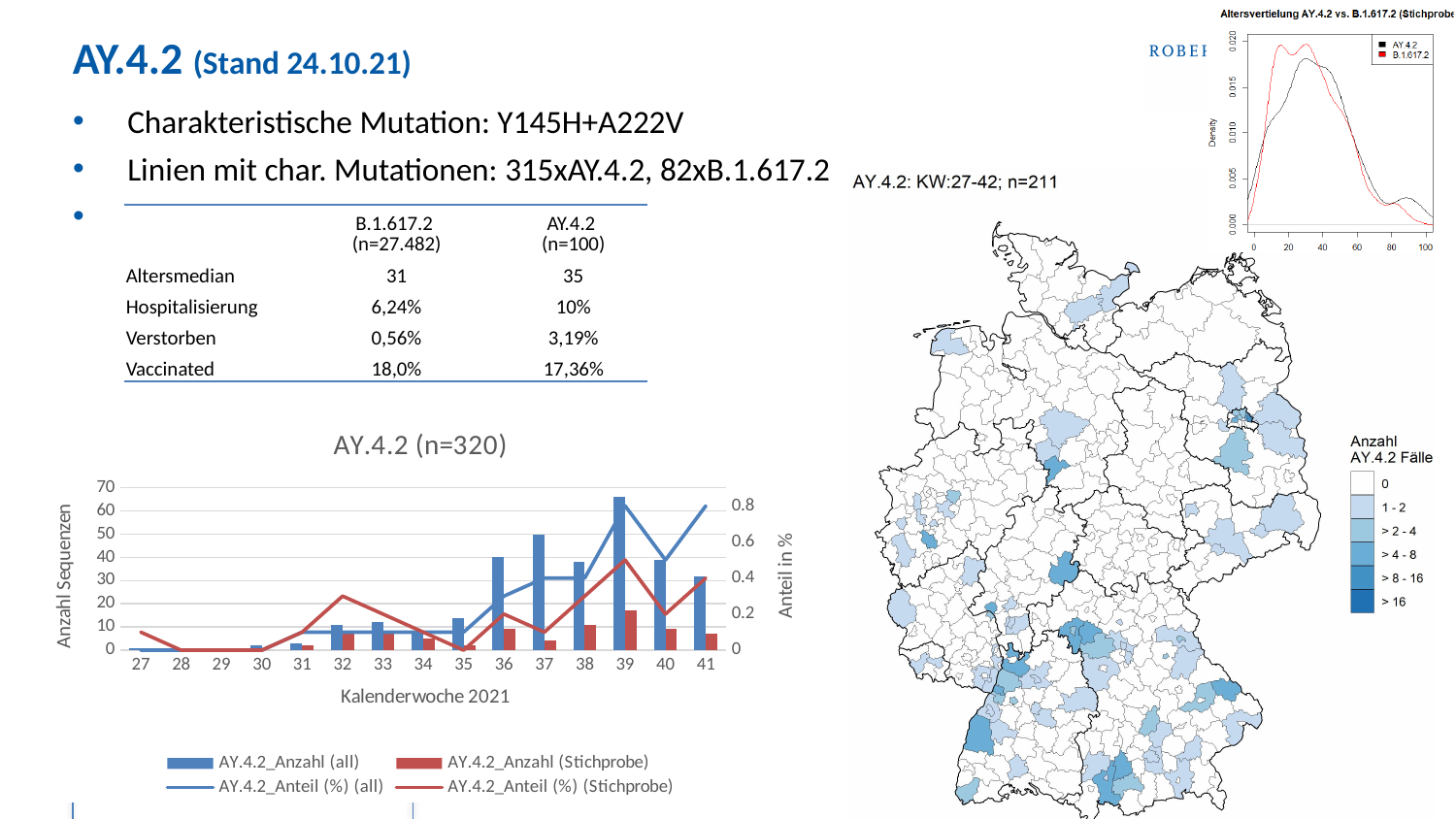
In the chart titled "AY.4.2 (n=320)", is the AY.4.2_Anzahl (all) value for week 36 greater or less than 30? greater In the chart titled "AY.4.2 (n=320)", which calendar week has the highest AY.4.2_Anzahl (all) bar? 39 In the chart titled "AY.4.2 (n=320)", how many calendar weeks are shown on the x axis? 15 In the chart titled "AY.4.2 (n=320)", does the AY.4.2_Anteil (%) (all) line rise or fall from week 35 to week 39? Rise In the chart titled "AY.4.2 (n=320)", which is larger, the AY.4.2_Anzahl (all) bar for week 39 or for week 40? Week 39 In the chart titled "AY.4.2 (n=320)", which is larger, the AY.4.2_Anzahl (all) bar for week 36 or for week 37? Week 37 In the chart titled "AY.4.2 (n=320)", which calendar week has the highest AY.4.2_Anzahl (Stichprobe) bar? 39 In the chart titled "AY.4.2 (n=320)", is the AY.4.2_Anzahl (all) value for week 39 greater or less than 60? greater In the chart titled "AY.4.2 (n=320)", what kind of chart is shown? A combined bar and line chart In the chart titled "AY.4.2 (n=320)", is the AY.4.2_Anzahl (Stichprobe) value for week 39 greater or less than 10? greater In the chart titled "AY.4.2 (n=320)", how many series does the legend list? 4 In the chart titled "AY.4.2 (n=320)", what is the title of the x axis? Kalenderwoche 2021